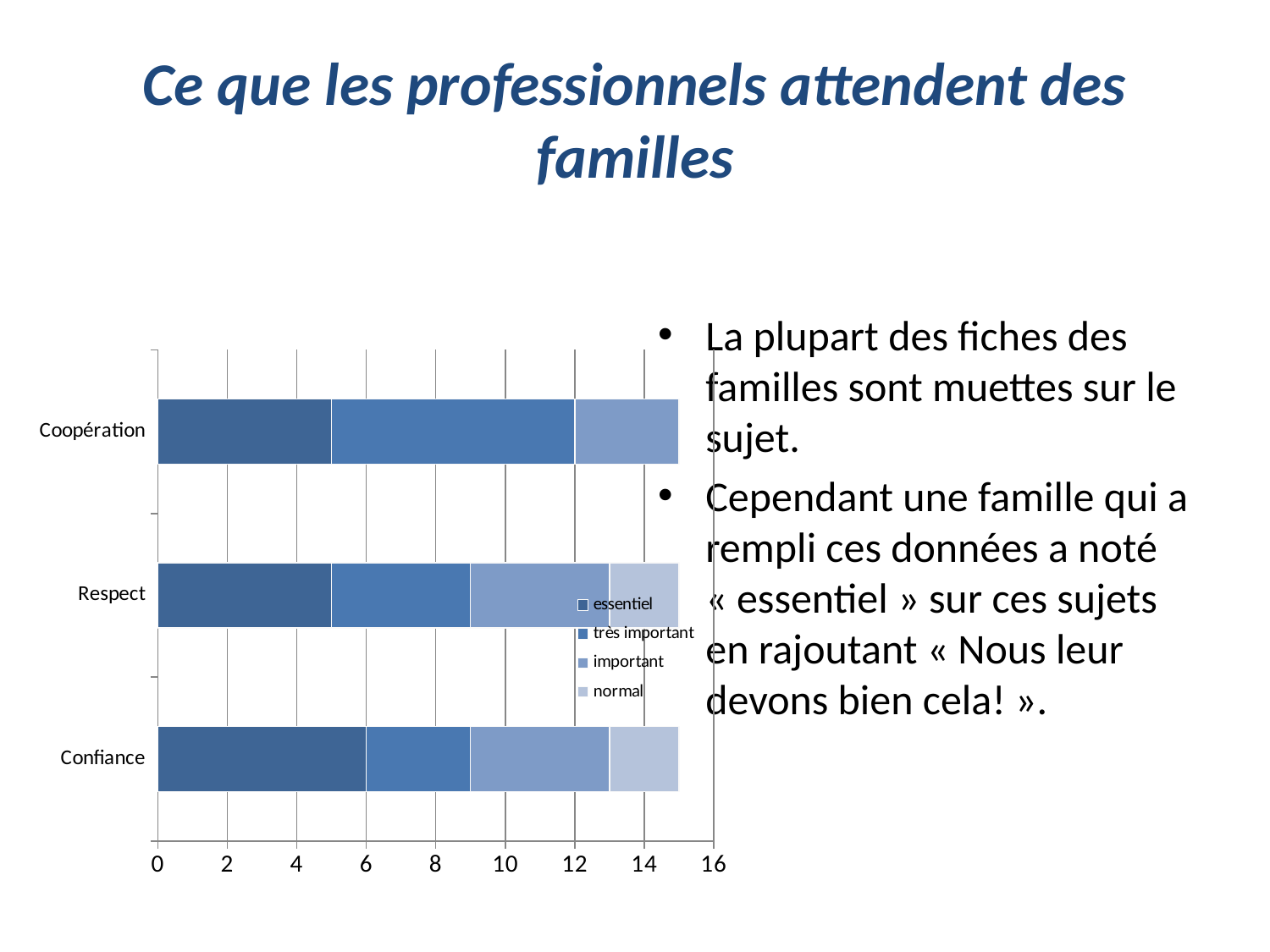
What are the legend entries of the chart? essentiel, très important, important, normal What is the value of the 'essentiel' segment for Confiance? 6 Is the 'essentiel' segment for Coopération greater or less than 4? greater Which category has no 'normal' segment in its bar? Coopération How many series does the chart legend list? 4 Is the total length of the Coopération bar greater or less than 14? greater Is the total length of the Respect bar greater or less than 14? greater Which category has the largest 'essentiel' segment? Confiance Which category is shown at the top of the chart? Coopération Which has the larger 'très important' segment, Coopération or Respect? Coopération How many categories are shown on the vertical axis of the chart? 3 What kind of chart is shown on the slide? Stacked bar chart